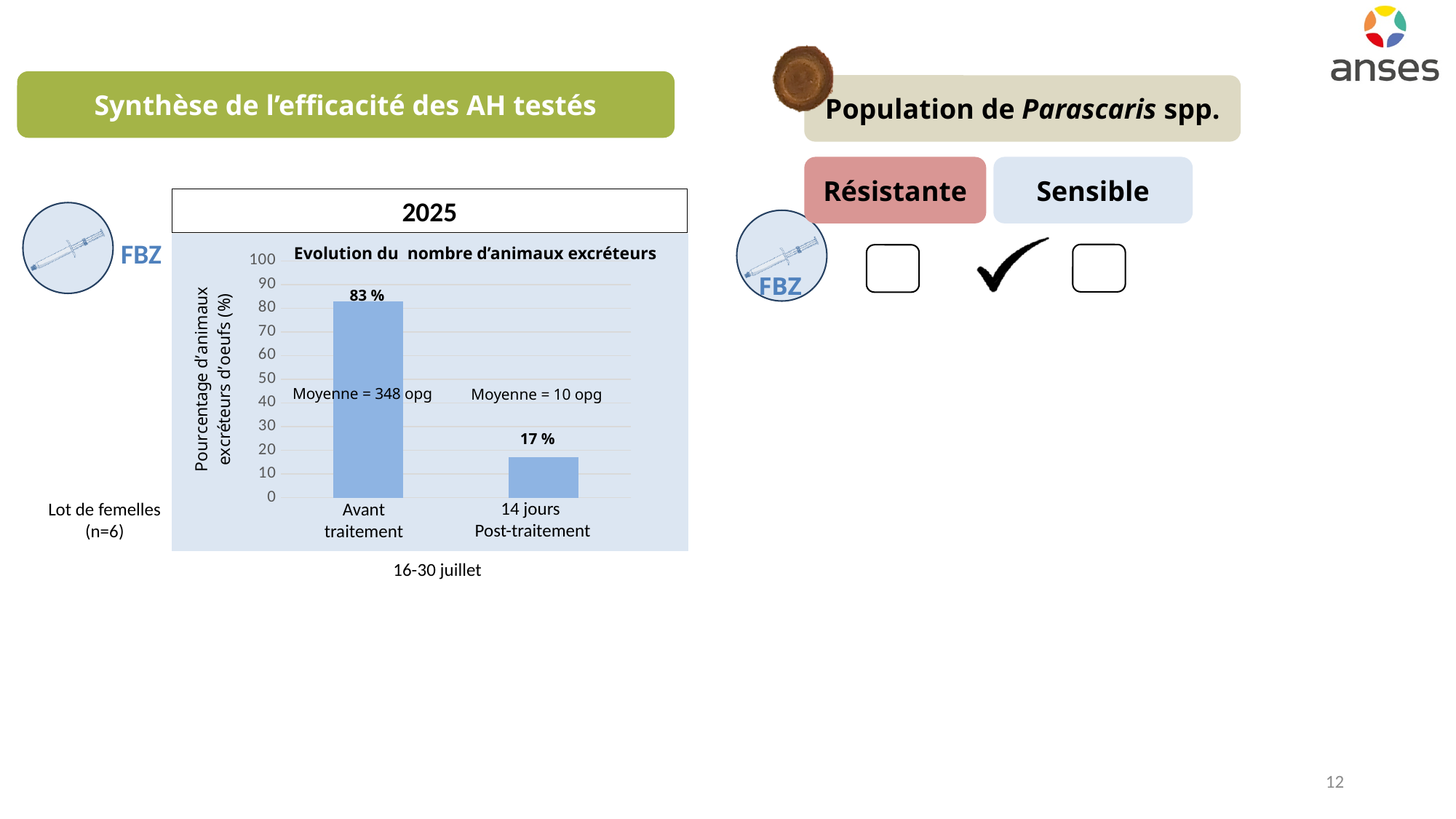
What is the difference between the values for "Avant traitement" and "14 jours Post-traitement"? 66 % How many categories are shown on the x axis? 2 What is the title of the chart? Evolution du nombre d'animaux excréteurs Which category has the lowest value? 14 jours Post-traitement What is the value for "14 jours Post-traitement"? 17 % What kind of chart is shown? bar chart Is the value for "14 jours Post-traitement" greater or less than 20? less What is the value for "Avant traitement"? 83 % Do the values rise or fall from "Avant traitement" to "14 jours Post-traitement"? fall Is the value for "Avant traitement" greater or less than 80? greater Which category has the highest value? Avant traitement Which is larger, the value for "Avant traitement" or for "14 jours Post-traitement"? Avant traitement